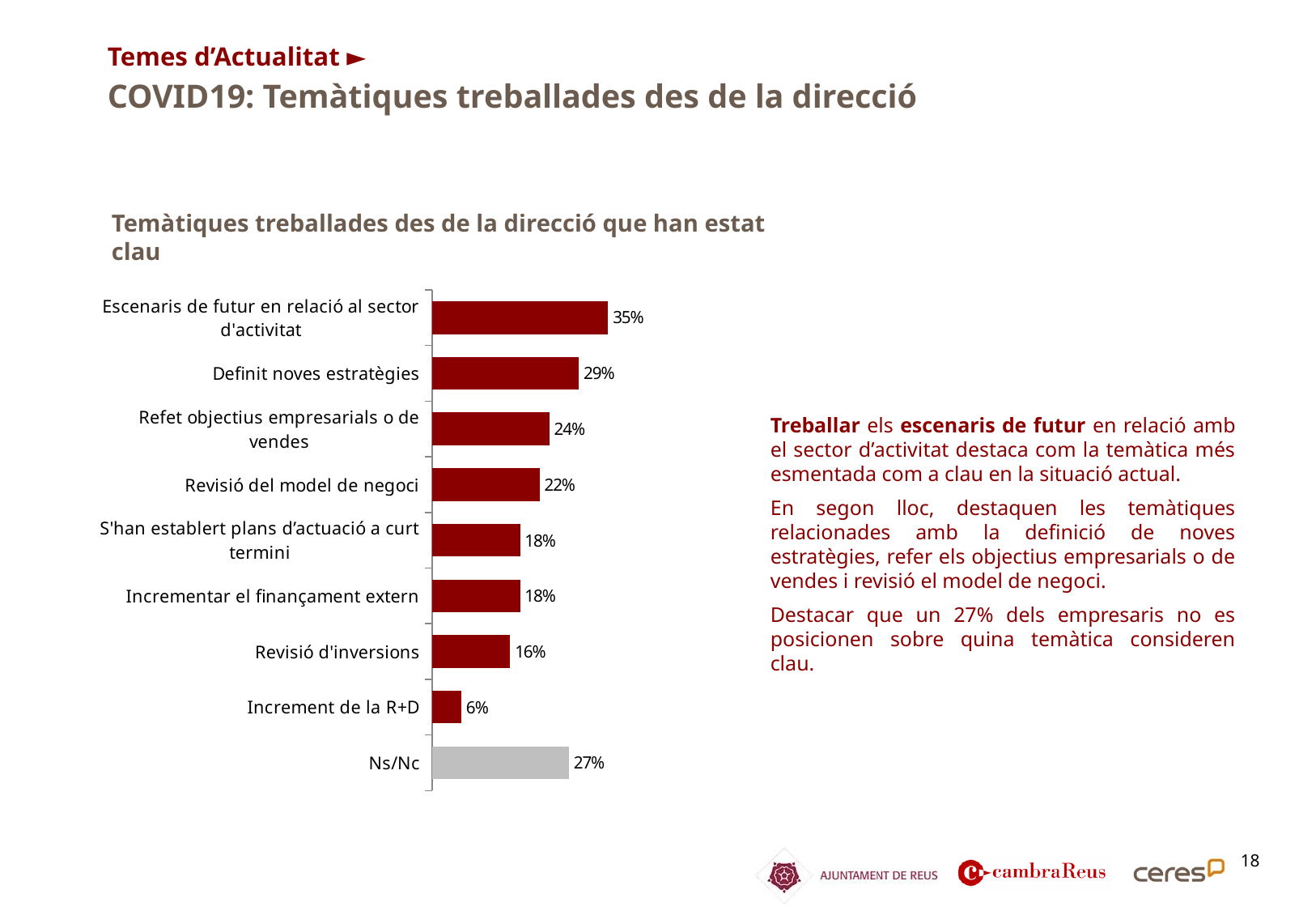
What is the difference between "Refet objectius empresarials o de vendes" and "Revisió d'inversions"? 8% How many categories are shown in the chart? 9 What is the value for "Ns/Nc"? 27% What is the title of the chart? Temàtiques treballades des de la direcció que han estat clau Which category has the lowest value? Increment de la R+D What is the value for "Revisió del model de negoci"? 22% Which category has the highest value? Escenaris de futur en relació al sector d'activitat What is the value for "Increment de la R+D"? 6% What is the value for "Definit noves estratègies"? 29% What kind of chart is shown on the slide? Bar chart What is the difference between "Escenaris de futur en relació al sector d'activitat" and "Definit noves estratègies"? 6% Which is larger: "Revisió del model de negoci" or "Incrementar el finançament extern"? Revisió del model de negoci